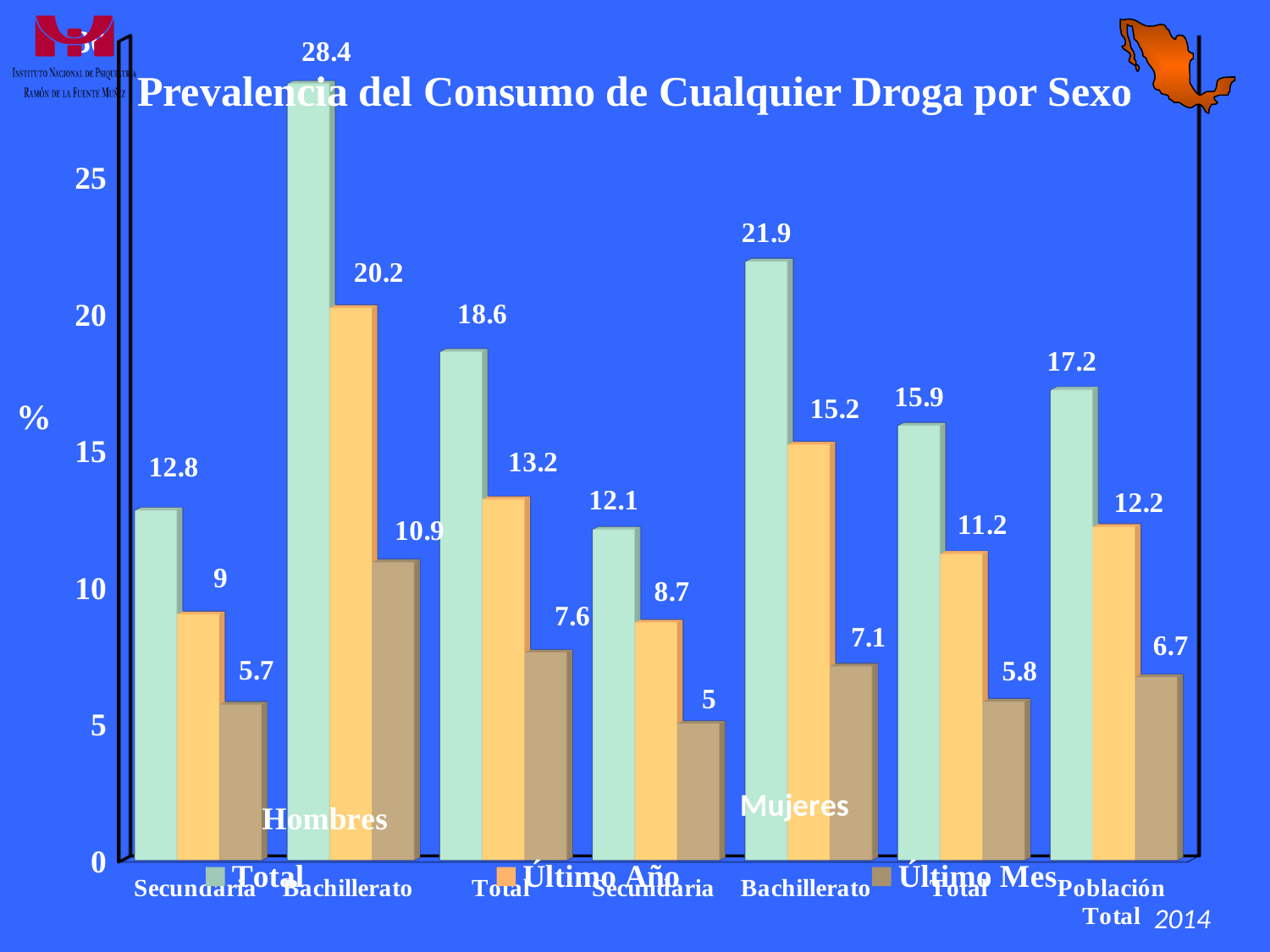
Which is larger: the Último Año value for Total among Hombres or the Último Año value for Total among Mujeres? Total among Hombres Which category has the lowest Último Mes value? Secundaria (Mujeres) What is the Total value for Bachillerato among Hombres? 28.4 What is the Último Año value for Población Total? 12.2 Which series is shown in orange in the legend? Último Año What is the title of the chart? Prevalencia del Consumo de Cualquier Droga por Sexo How many series does the legend list? 3 What is the Último Mes value for Secundaria among Mujeres? 5 What kind of chart is shown on the slide? Bar chart Which category has the highest Total value? Bachillerato (Hombres) How many categories are shown on the x axis? 7 What is the difference between the Total value for Bachillerato among Hombres and the Total value for Bachillerato among Mujeres? 6.5